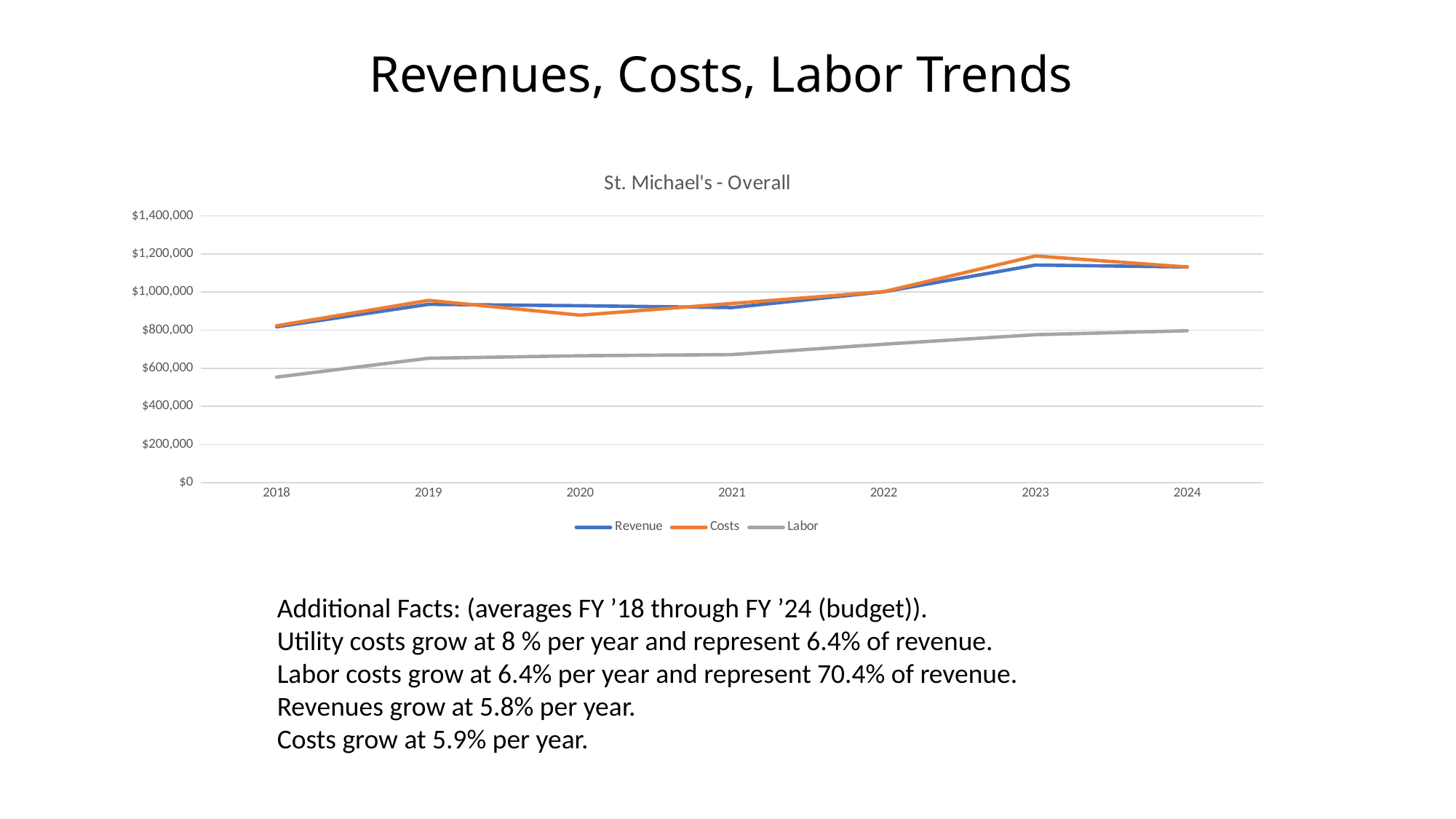
What kind of chart is shown on the slide? Line chart In which year is the Labor value lowest? 2018 In 2020, which is larger, Revenue or Costs? Revenue Which series is drawn in gray in the chart? Labor How many years are plotted along the x axis of the chart? 7 What is the title shown above the chart's plot area? St. Michael's - Overall In which year does the Costs line reach its highest value? 2023 How many series does the chart legend list? 3 Does the Labor line generally rise or fall from 2018 to 2024? Rise Which series has the lowest values across all years in the chart? Labor Is the Revenue value for 2023 greater or less than $1,000,000? greater Is the Labor value for 2018 greater or less than $600,000? less